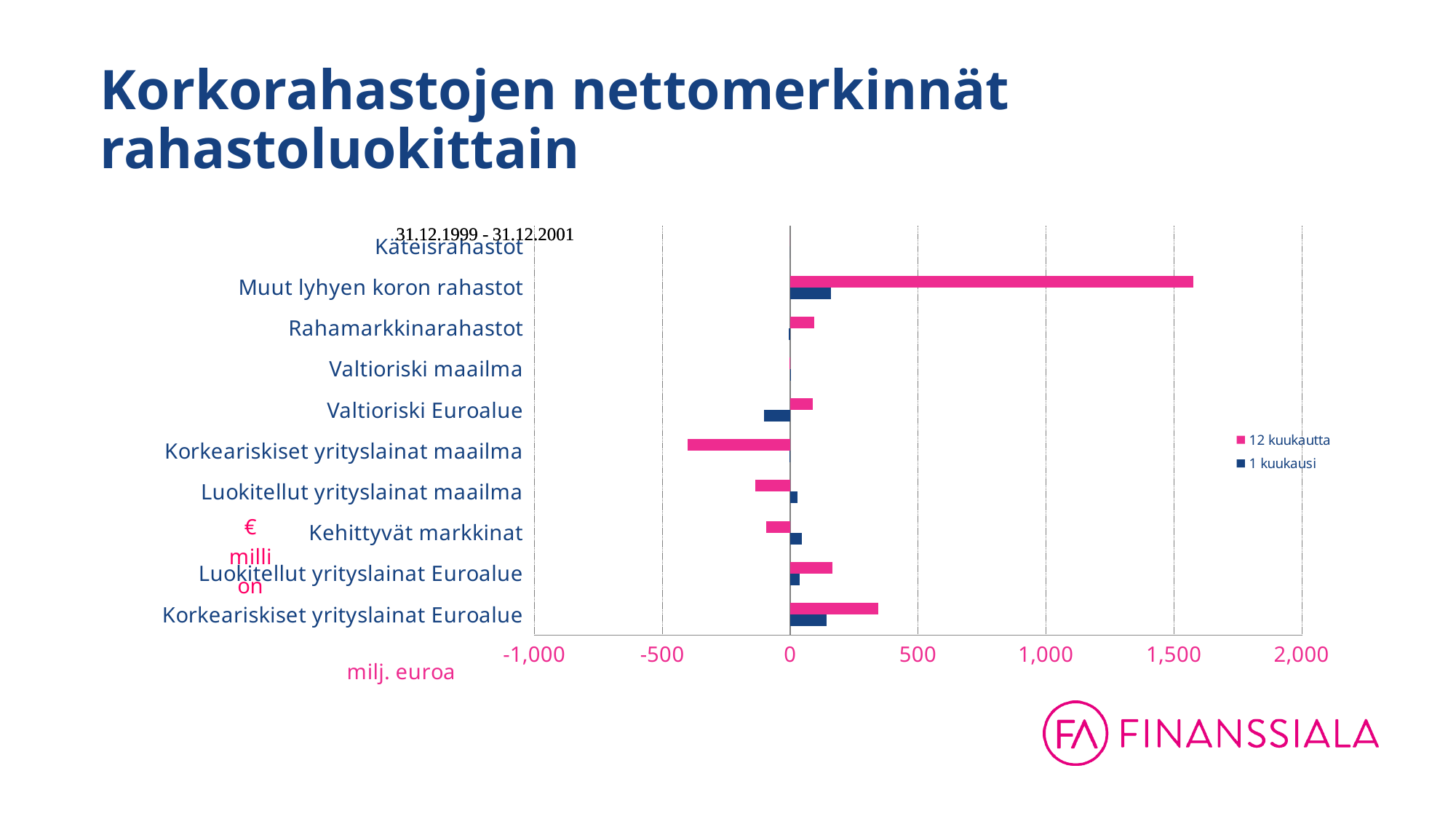
What are the two series named in the legend? 12 kuukautta and 1 kuukausi How many fund categories are shown on the chart? 10 Is the 12 kuukautta value for Muut lyhyen koron rahastot greater or less than 1,500? greater What kind of chart is shown on the slide? bar chart How many series does the legend list? 2 Which category has the lowest 12 kuukautta value? Korkeariskiset yrityslainat maailma Is the 12 kuukautta value for Korkeariskiset yrityslainat maailma greater or less than -500? greater What unit label is shown on the x axis? milj. euroa Which category has the lowest 1 kuukausi value? Valtioriski Euroalue Is the 12 kuukautta value for Korkeariskiset yrityslainat Euroalue greater or less than 500? less Which has the larger 12 kuukautta value: Korkeariskiset yrityslainat Euroalue or Luokitellut yrityslainat Euroalue? Korkeariskiset yrityslainat Euroalue Which category has the highest 12 kuukautta value? Muut lyhyen koron rahastot